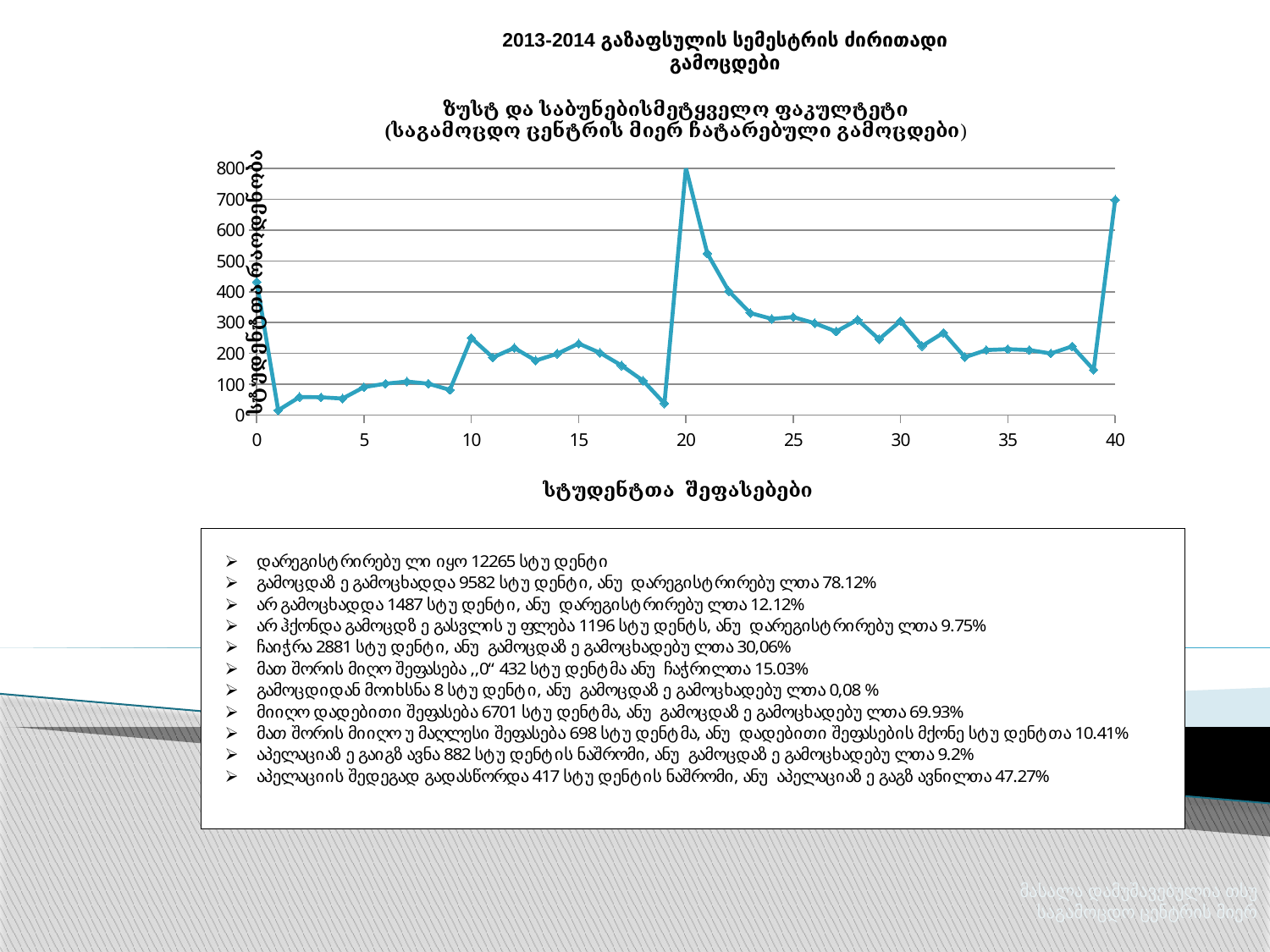
Do the values rise or fall along the x axis between x = 20 and x = 25? fall Is the value at x = 40 greater or less than 600? greater Is the value at x = 19 greater or less than 100? less Is the value at x = 30 greater or less than 200? greater Which is larger, the value at x = 30 or the value at x = 39? x = 30 At which x-axis value does the line reach its highest point? 20 Which is larger, the value at x = 20 or the value at x = 40? x = 20 What is the label on the vertical axis of the chart? სტუდენტთა რაოდენობა What kind of chart is shown on the slide? line chart